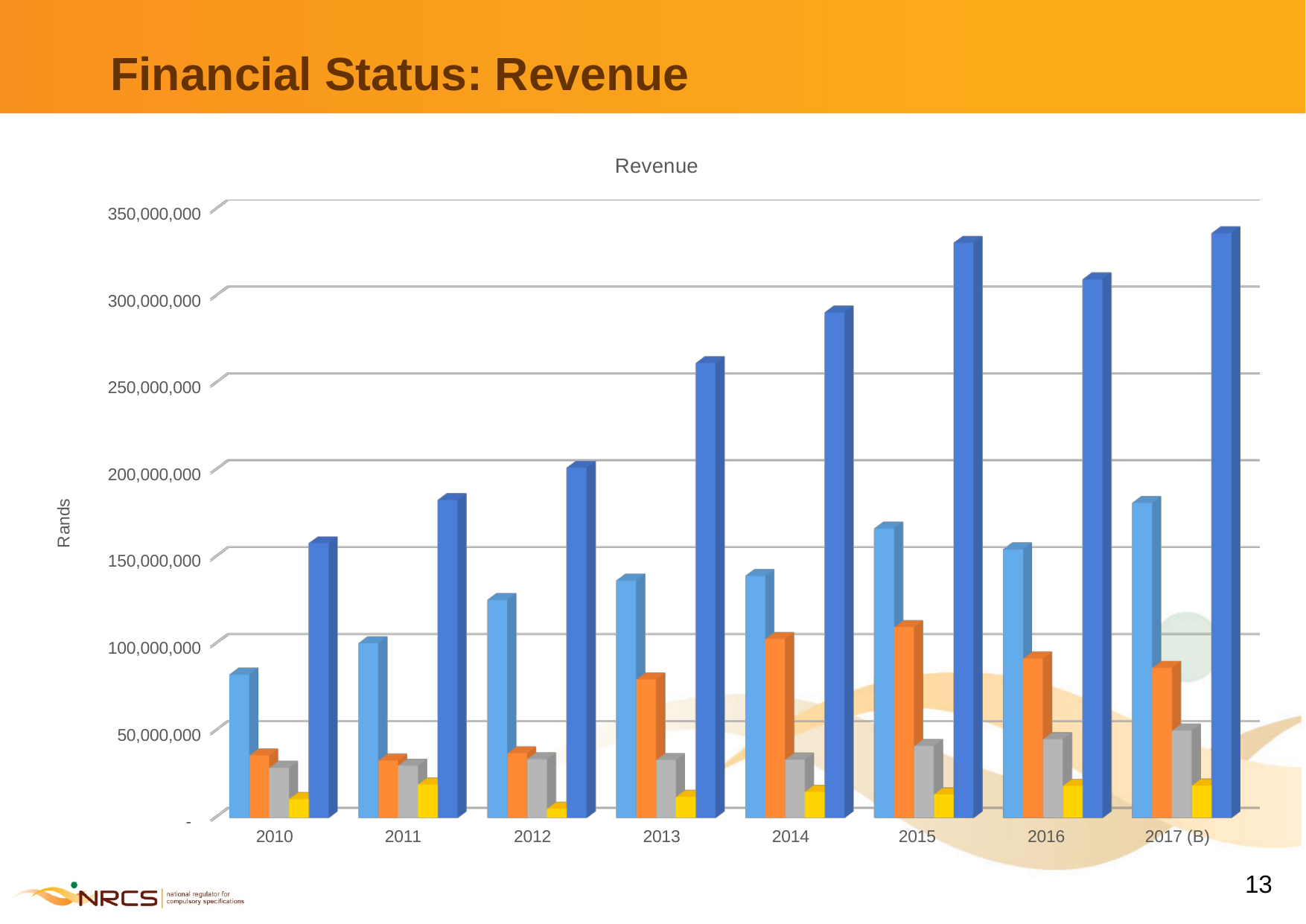
In which year is the light blue bar the highest? 2017 (B) What kind of chart is shown on the slide? bar chart In which year is the dark blue bar the lowest? 2010 Which year has the larger dark blue bar, 2015 or 2016? 2015 Is the light blue bar for 2012 greater or less than 100,000,000? greater Is the light blue bar for 2017 (B) greater or less than 200,000,000? less How many bars are plotted for each year in the Revenue chart? 5 Is the dark blue bar for 2013 greater or less than 250,000,000? greater How many years (categories) are shown on the x axis of the Revenue chart? 8 What is the label on the vertical axis of the chart? Rands What is the title of the chart? Revenue